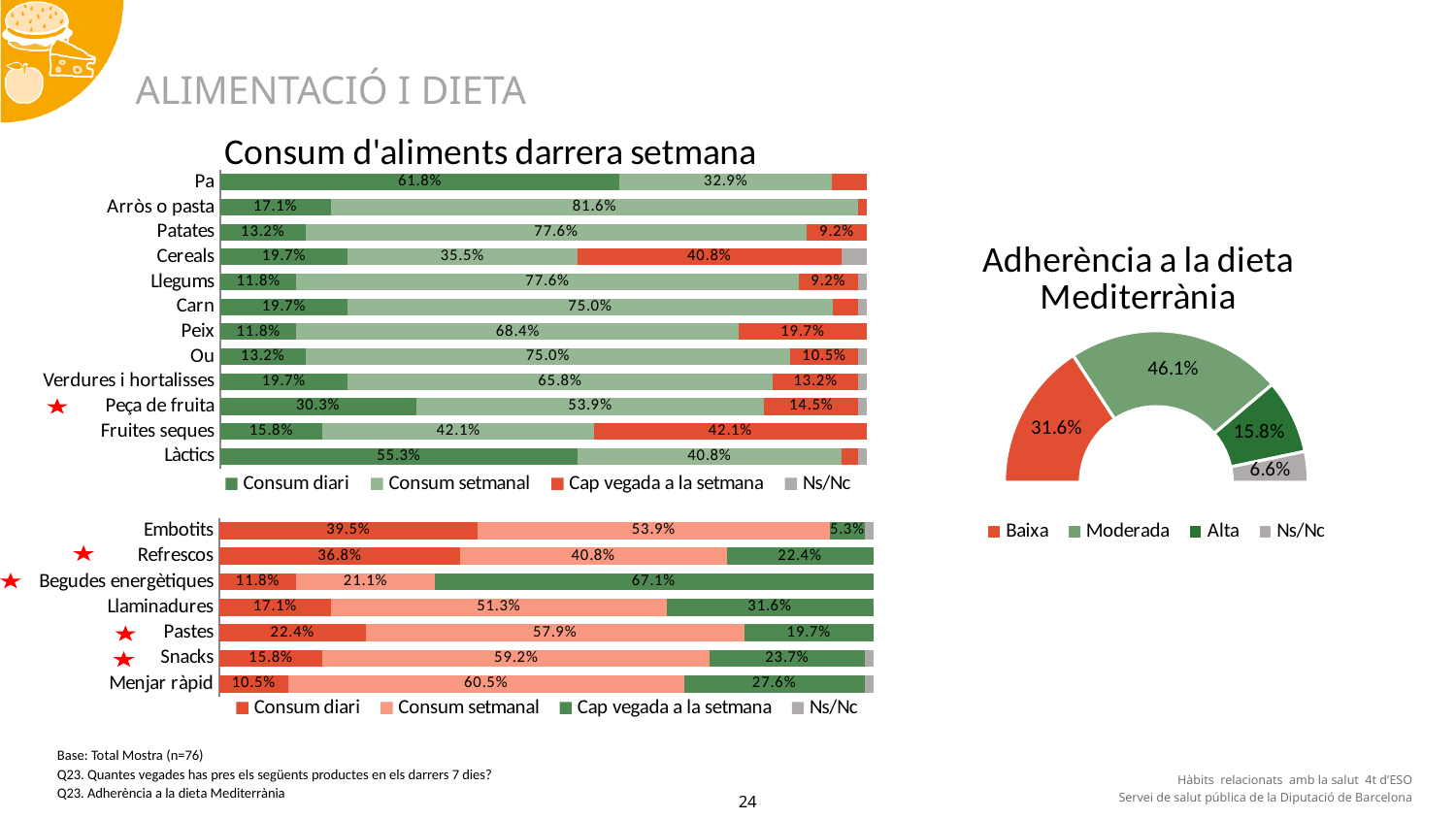
In the chart 'Consum d'aliments darrera setmana', what is the 'Consum diari' value for Pa? 61.8% In the chart 'Consum d'aliments darrera setmana', which category has the highest 'Consum diari' value? Pa In the chart 'Consum d'aliments darrera setmana', what is the 'Consum setmanal' value for Arròs o pasta? 81.6% In the chart 'Consum d'aliments darrera setmana', how many series does the legend list? 4 In the chart 'Adherència a la dieta Mediterrània', what share does Moderada have? 46.1% In the chart 'Consum d'aliments darrera setmana', how many food categories are listed? 12 What kind of chart is 'Adherència a la dieta Mediterrània'? Doughnut chart In the bottom-left chart, how many categories are shown? 7 In the bottom-left chart, what is the 'Cap vegada a la setmana' value for Begudes energètiques? 67.1% In the bottom-left chart, which category has the highest 'Consum diari' value? Embotits In the chart 'Consum d'aliments darrera setmana', what is the difference between the 'Cap vegada a la setmana' values for Cereals and Peix? 21.1% In the bottom-left chart, which is larger: the 'Consum setmanal' value for Menjar ràpid or for Refrescos? Menjar ràpid